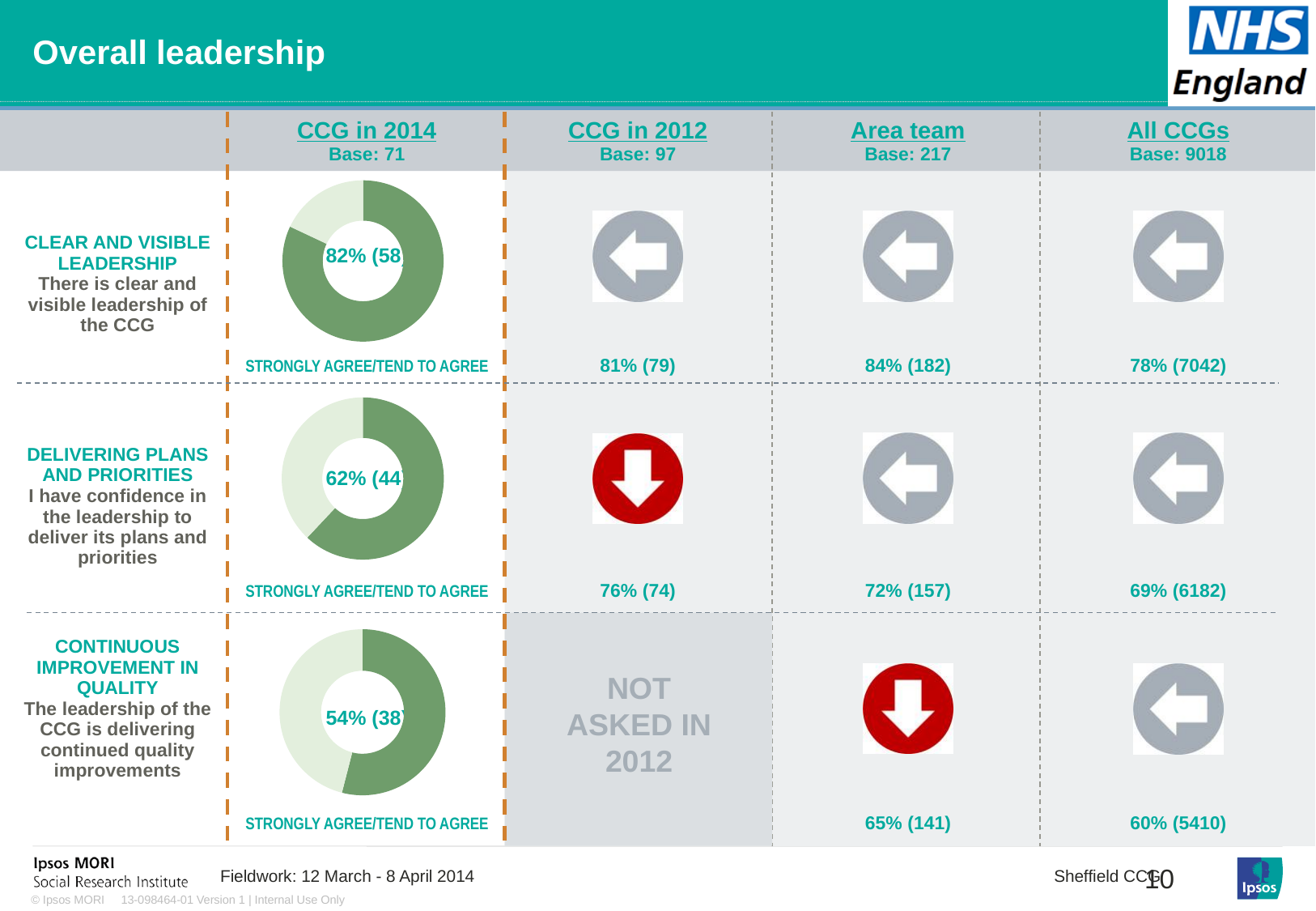
In the 'Continuous improvement in quality' donut chart, what value is shown for CCG in 2014? 54% (38) In the 'Clear and visible leadership' donut chart, what share of the ring is the dark green segment? 82% In the 'Delivering plans and priorities' donut chart, what value is shown for CCG in 2014? 62% (44) Which of the three donut charts shows the highest percentage for CCG in 2014? Clear and visible leadership What label appears beneath each donut chart in the 'CCG in 2014' column? STRONGLY AGREE/TEND TO AGREE In the 'Clear and visible leadership' donut chart, what percentage strongly agree/tend to agree for CCG in 2014? 82% (58) Which is larger for CCG in 2014: the 'Delivering plans and priorities' donut value or the 'Continuous improvement in quality' donut value? Delivering plans and priorities What kind of chart is used in the 'CCG in 2014' column to show the results? Donut (pie) chart Which of the three donut charts shows the lowest percentage for CCG in 2014? Continuous improvement in quality What is the base (number of respondents) for the 'CCG in 2014' donut charts? Base: 71 What is the difference in percentage points between the 'Clear and visible leadership' donut (82%) and the 'Delivering plans and priorities' donut (62%)? 20 percentage points How many donut charts are shown on the slide? 3